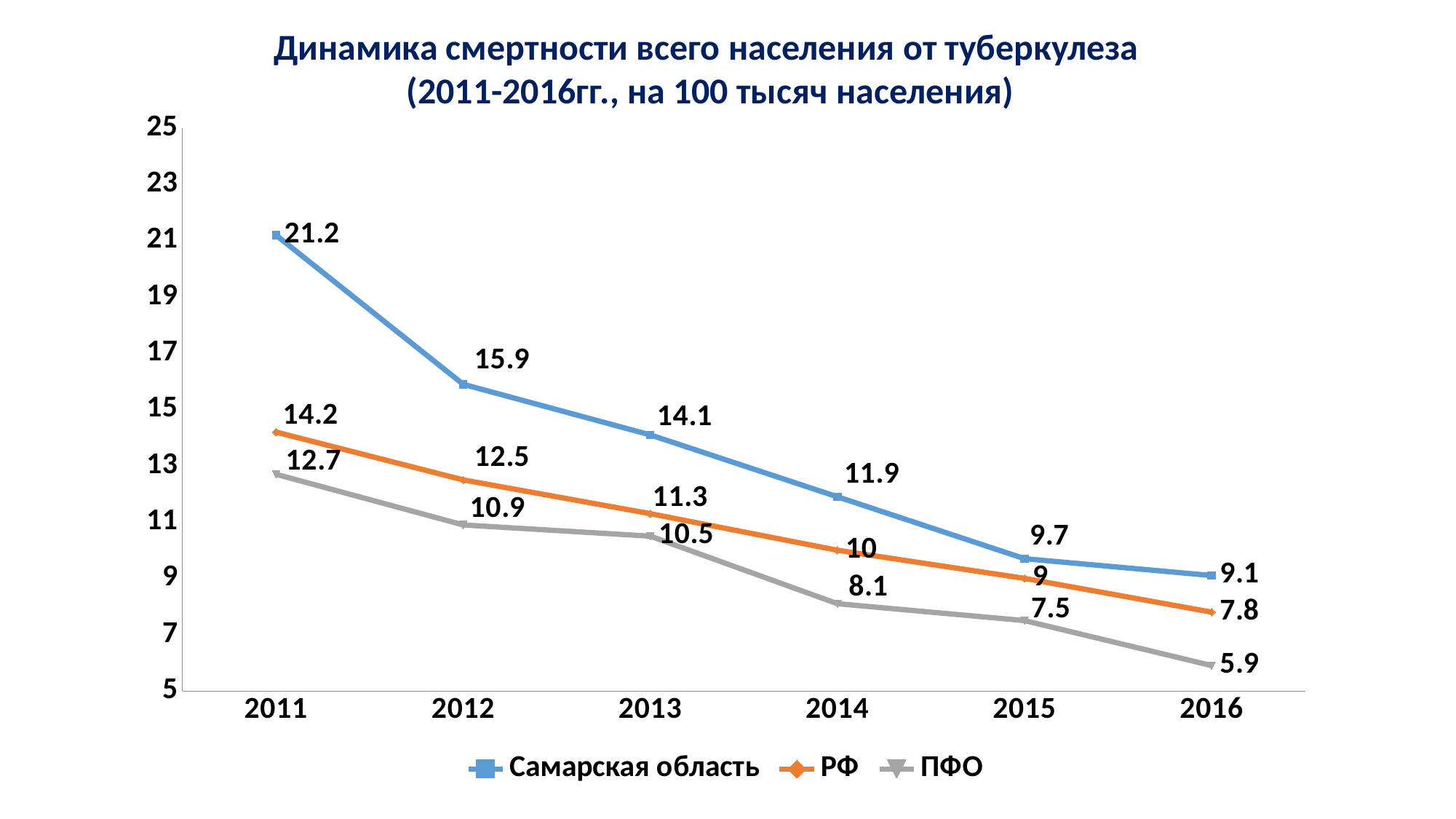
What is the difference between the Самарская область value in 2011 and in 2016? 12.1 How many series does the legend list? 3 What type of chart is shown on the slide? line chart What is the value for Самарская область in 2011? 21.2 What is the value for РФ in 2014? 10 What is the value for ПФО in 2016? 5.9 How many years are shown on the x axis? 6 Do the values for РФ rise or fall from 2011 to 2016? fall In which year is the value for Самарская область the lowest? 2016 In which year is the value for ПФО the highest? 2011 Which series is shown in orange in the legend? РФ Which is larger in 2013: the value for РФ or the value for ПФО? РФ